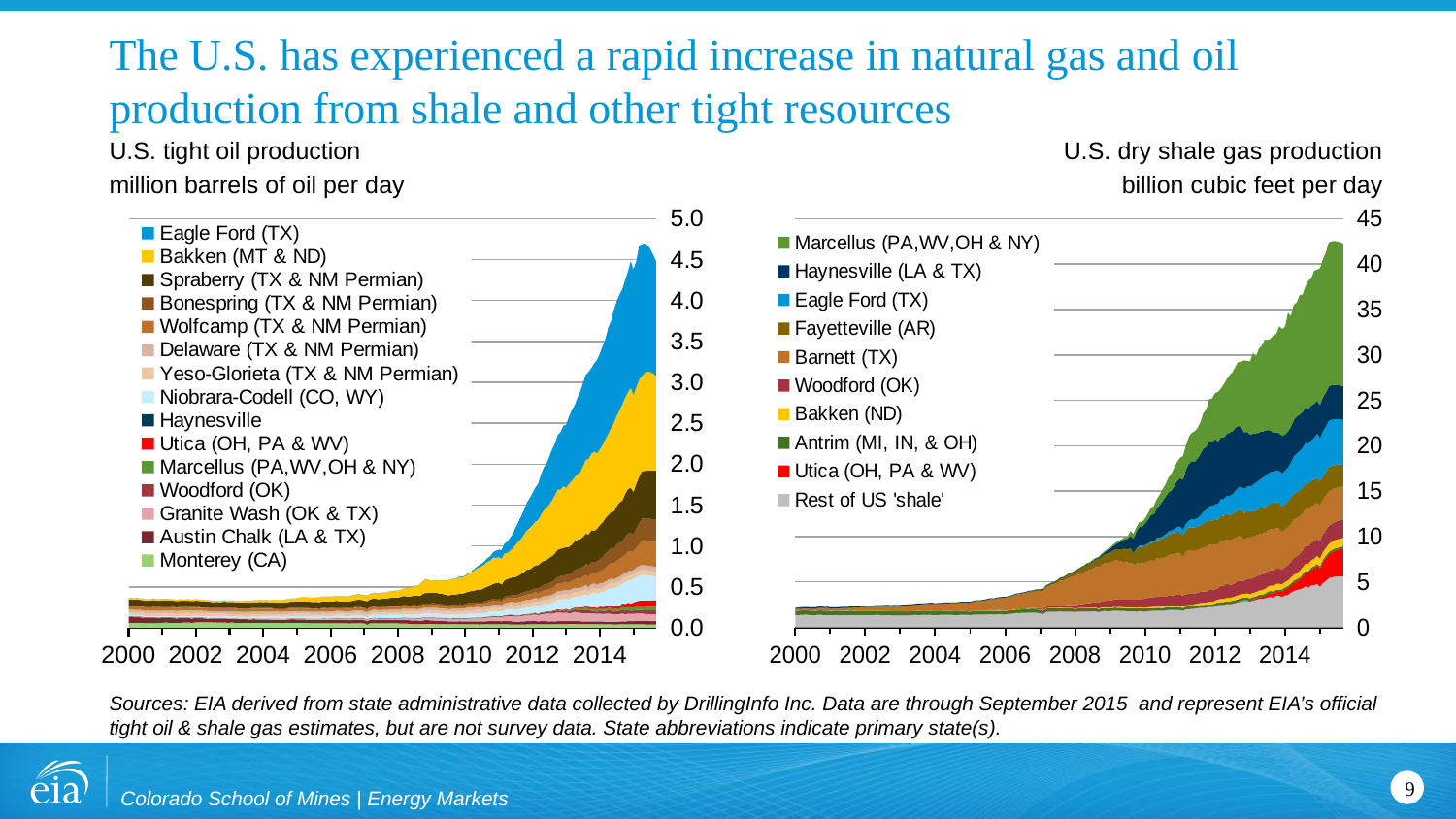
What unit is used on the y axis of the U.S. dry shale gas production chart? billion cubic feet per day What kind of chart is the U.S. dry shale gas production chart on the right? stacked area chart How many series does the legend of the U.S. dry shale gas production chart list? 10 In the U.S. tight oil production chart, does total production rise or fall from 2000 to 2015? rise In the U.S. tight oil production chart, is total production in 2000 greater or less than 0.5 million barrels per day? less How many series does the legend of the U.S. tight oil production chart list? 15 Which series is listed first in the legend of the U.S. tight oil production chart? Eagle Ford (TX) What kind of chart is the U.S. tight oil production chart on the left? stacked area chart In the U.S. tight oil production chart, is total production at its 2015 peak greater or less than 4.0 million barrels per day? greater In the U.S. dry shale gas production chart, does total production rise or fall from 2000 to 2015? rise In the U.S. dry shale gas production chart, is total production in 2000 greater or less than 5 billion cubic feet per day? less